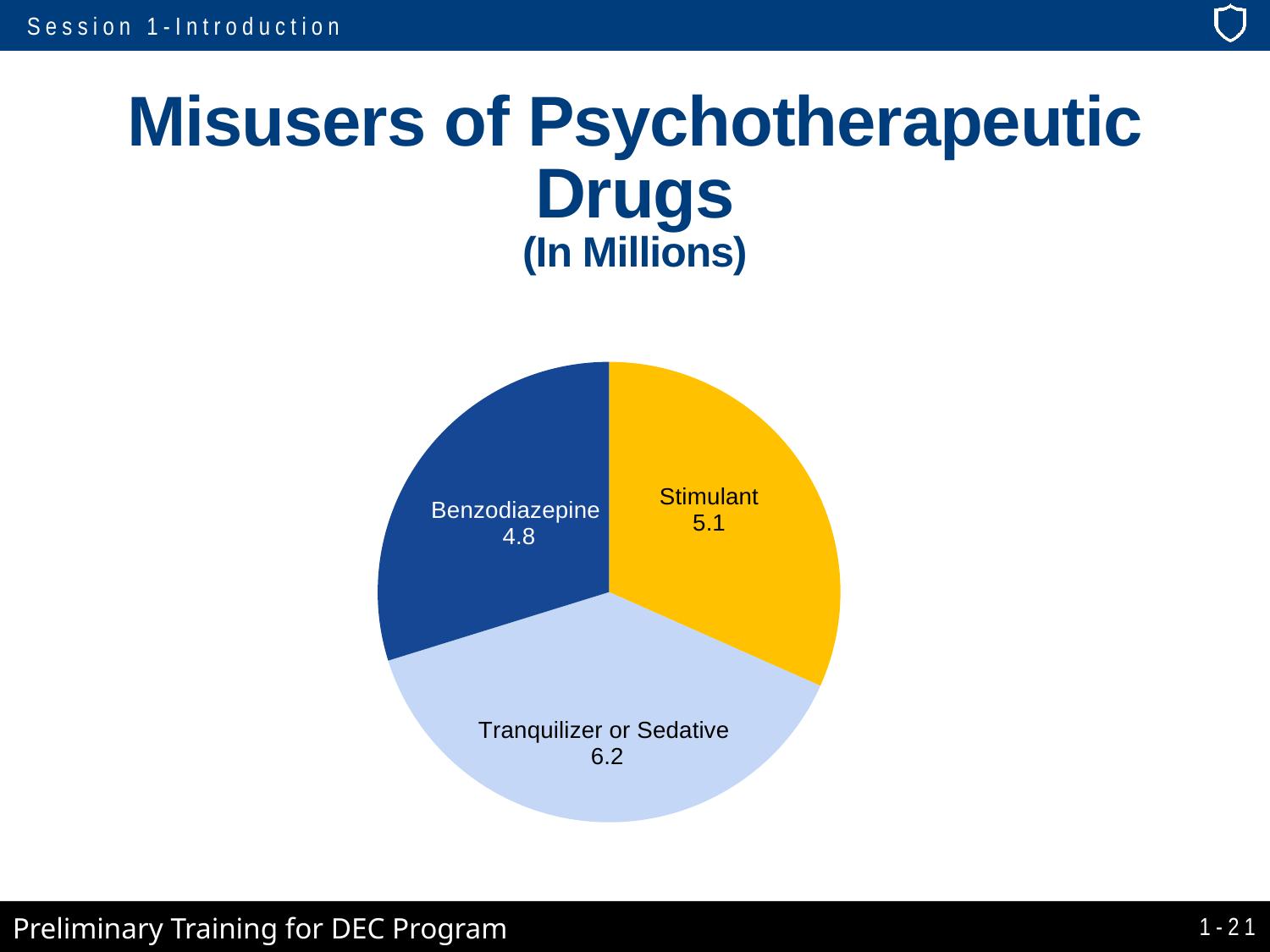
What is the title of the chart on the slide? Misusers of Psychotherapeutic Drugs (In Millions) What is the difference between the Tranquilizer or Sedative value and the Stimulant value? 1.1 What is the total of all three slices in the pie chart? 16.1 Which category has the largest slice of the pie? Tranquilizer or Sedative What is the value for Benzodiazepine? 4.8 How many categories are shown in the pie chart? 3 What type of chart is shown on the slide? Pie chart Which category has the smallest slice of the pie? Benzodiazepine What is the difference between the Tranquilizer or Sedative value and the Benzodiazepine value? 1.4 What is the value for Tranquilizer or Sedative? 6.2 Which is larger, the value for Stimulant or the value for Benzodiazepine? Stimulant What is the value for Stimulant? 5.1